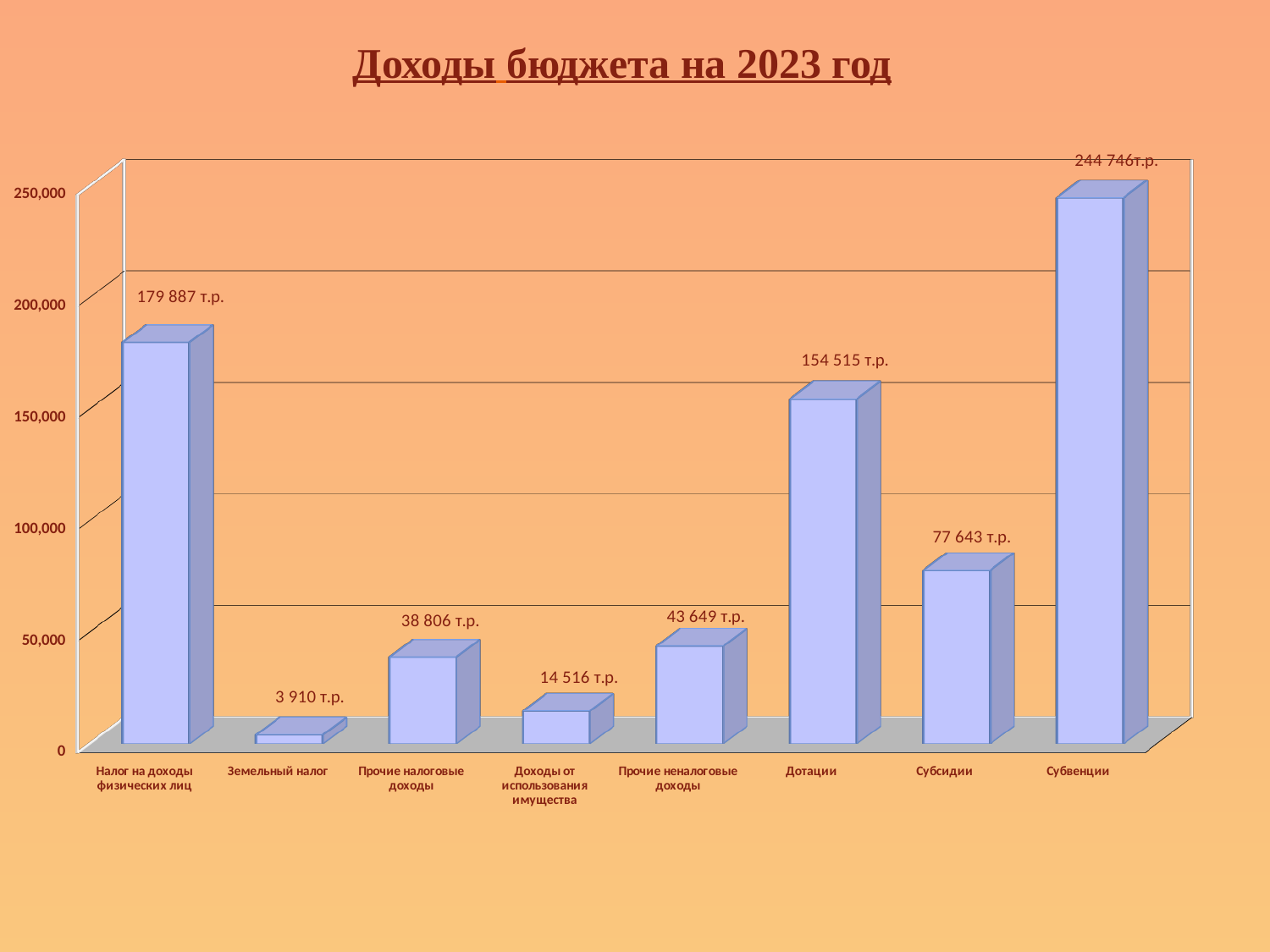
Which category has the lowest value? Земельный налог Which is larger, Прочие налоговые доходы or Прочие неналоговые доходы? Прочие неналоговые доходы What is the title of the chart? Доходы бюджета на 2023 год What is the difference between Субвенции and Налог на доходы физических лиц? 64 859 т.р. What is the value for Дотации? 154 515 т.р. How many categories are shown on the chart? 8 Is the value for Дотации greater or less than 150,000? greater What is the value for Субсидии? 77 643 т.р. What is the difference between Дотации and Субсидии? 76 872 т.р. What is the value for Земельный налог? 3 910 т.р. Which category has the highest value? Субвенции What is the value for Налог на доходы физических лиц? 179 887 т.р.